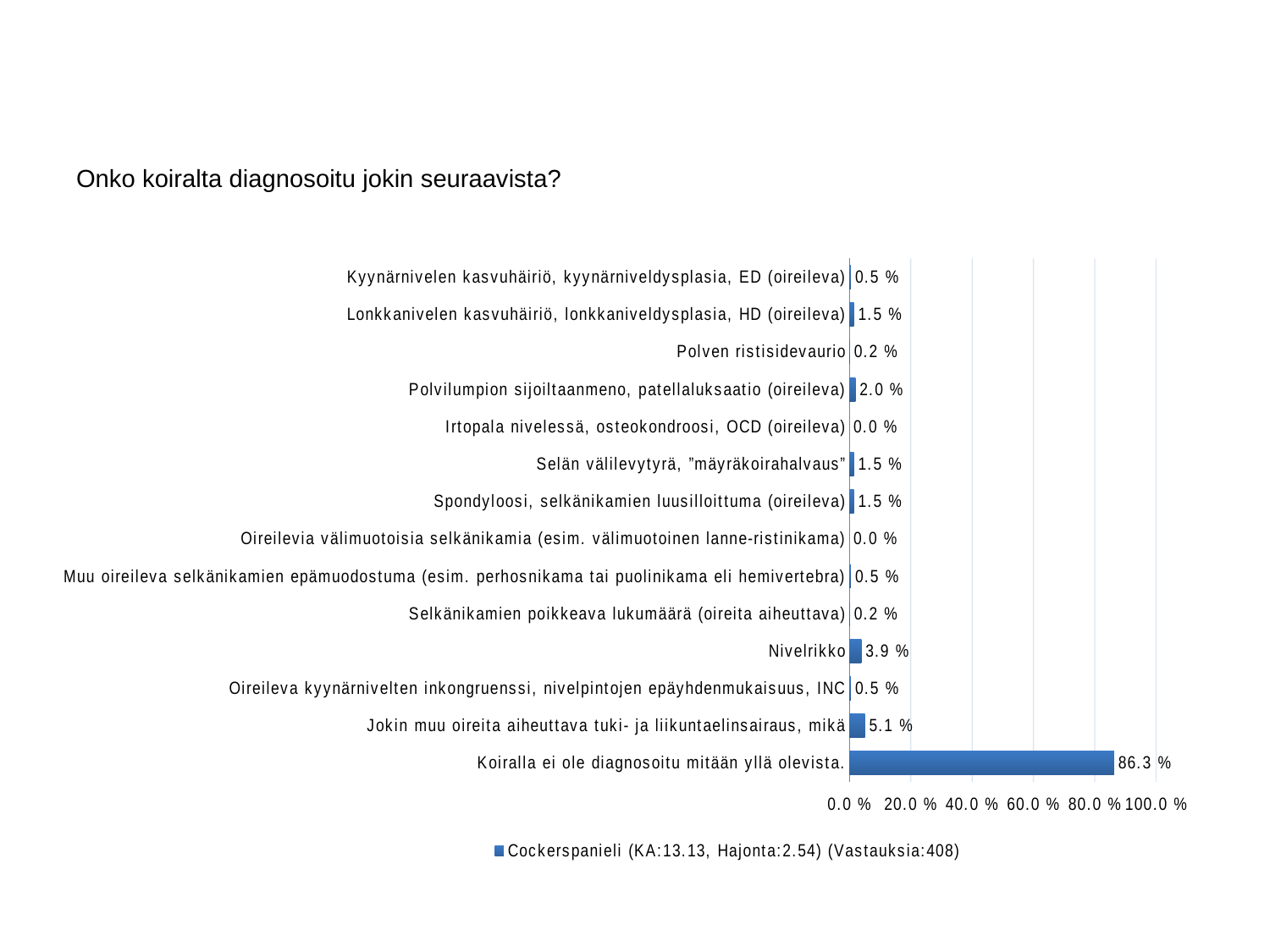
Which category has the highest value? Koiralla ei ole diagnosoitu mitään yllä olevista. Which is larger: the value for "Nivelrikko" or the value for "Polvilumpion sijoiltaanmeno, patellaluksaatio (oireileva)"? Nivelrikko What is the value for "Koiralla ei ole diagnosoitu mitään yllä olevista."? 86.3 % What is the value for "Nivelrikko"? 3.9 % What is the difference between the values for "Jokin muu oireita aiheuttava tuki- ja liikuntaelinsairaus, mikä" and "Nivelrikko"? 1.2 % Is the value for "Koiralla ei ole diagnosoitu mitään yllä olevista." greater or less than 80.0 %? greater What is the value for "Polven ristisidevaurio"? 0.2 % What is the title of the chart? Onko koiralta diagnosoitu jokin seuraavista? What type of chart is shown on the slide? bar chart What is the value for "Jokin muu oireita aiheuttava tuki- ja liikuntaelinsairaus, mikä"? 5.1 % How many categories are shown in the chart? 14 What is the value for "Polvilumpion sijoiltaanmeno, patellaluksaatio (oireileva)"? 2.0 %